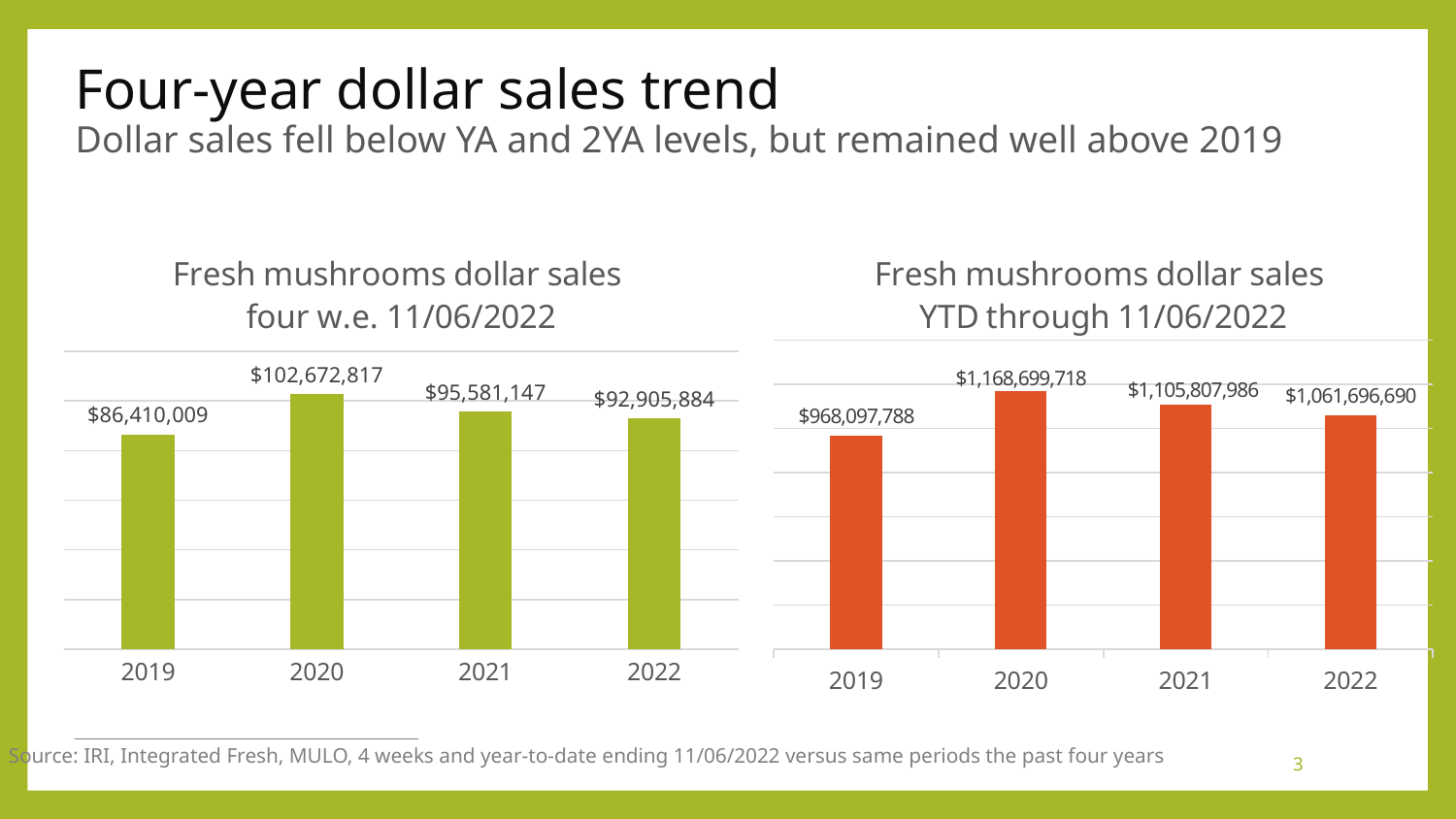
What colour are the bars in the 'Fresh mushrooms dollar sales YTD through 11/06/2022' chart? Orange In the 'Fresh mushrooms dollar sales YTD through 11/06/2022' chart, which year has the lowest value? 2019 In the 'Fresh mushrooms dollar sales four w.e. 11/06/2022' chart, what is the value for 2019? $86,410,009 In the 'Fresh mushrooms dollar sales YTD through 11/06/2022' chart, which is larger, the value for 2019 or the value for 2022? 2022 In the 'Fresh mushrooms dollar sales YTD through 11/06/2022' chart, what is the value for 2022? $1,061,696,690 In the 'Fresh mushrooms dollar sales four w.e. 11/06/2022' chart, which is larger, the value for 2021 or the value for 2022? 2021 What kind of chart is the 'Fresh mushrooms dollar sales YTD through 11/06/2022' chart? Bar chart In the 'Fresh mushrooms dollar sales YTD through 11/06/2022' chart, do the values rise or fall from 2020 to 2022? Fall In the 'Fresh mushrooms dollar sales four w.e. 11/06/2022' chart, which year has the highest value? 2020 How many years are shown in the 'Fresh mushrooms dollar sales four w.e. 11/06/2022' chart? 4 In the 'Fresh mushrooms dollar sales YTD through 11/06/2022' chart, what is the difference between the 2020 and 2021 values? $62,891,732 In the 'Fresh mushrooms dollar sales four w.e. 11/06/2022' chart, what is the difference between the 2020 and 2019 values? $16,262,808